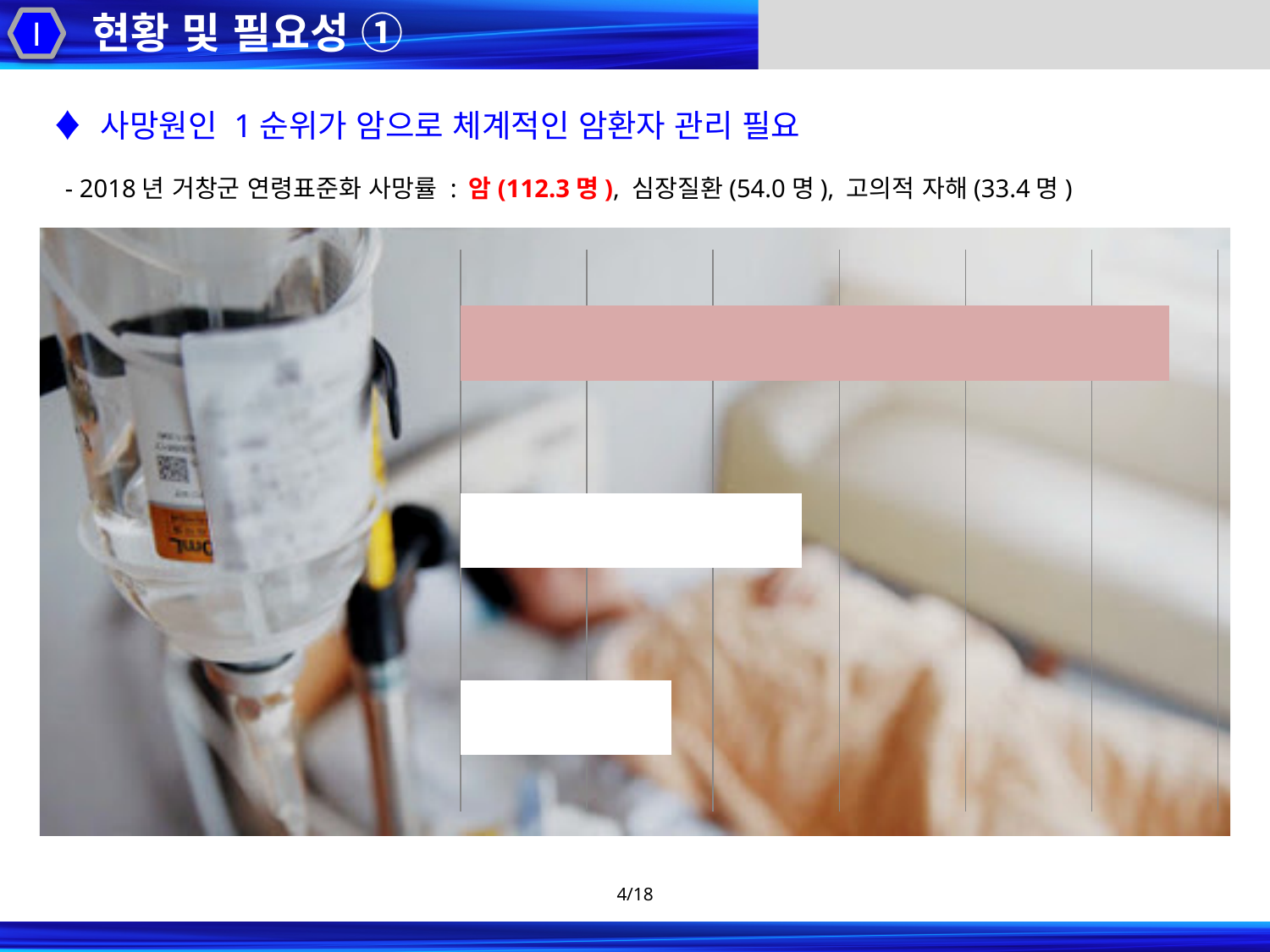
What colour are the middle and bottom bars in the chart? white Is the top bar or the bottom bar longer? the top bar Do the bar lengths increase or decrease going from the top bar to the bottom bar? decrease What kind of chart is shown on the slide? bar chart Is the middle bar or the bottom bar longer? the middle bar Which bar in the chart is the longest? the top bar What colour is the top bar in the chart? pink How many bars does the chart contain? 3 Which bar in the chart is the shortest? the bottom bar